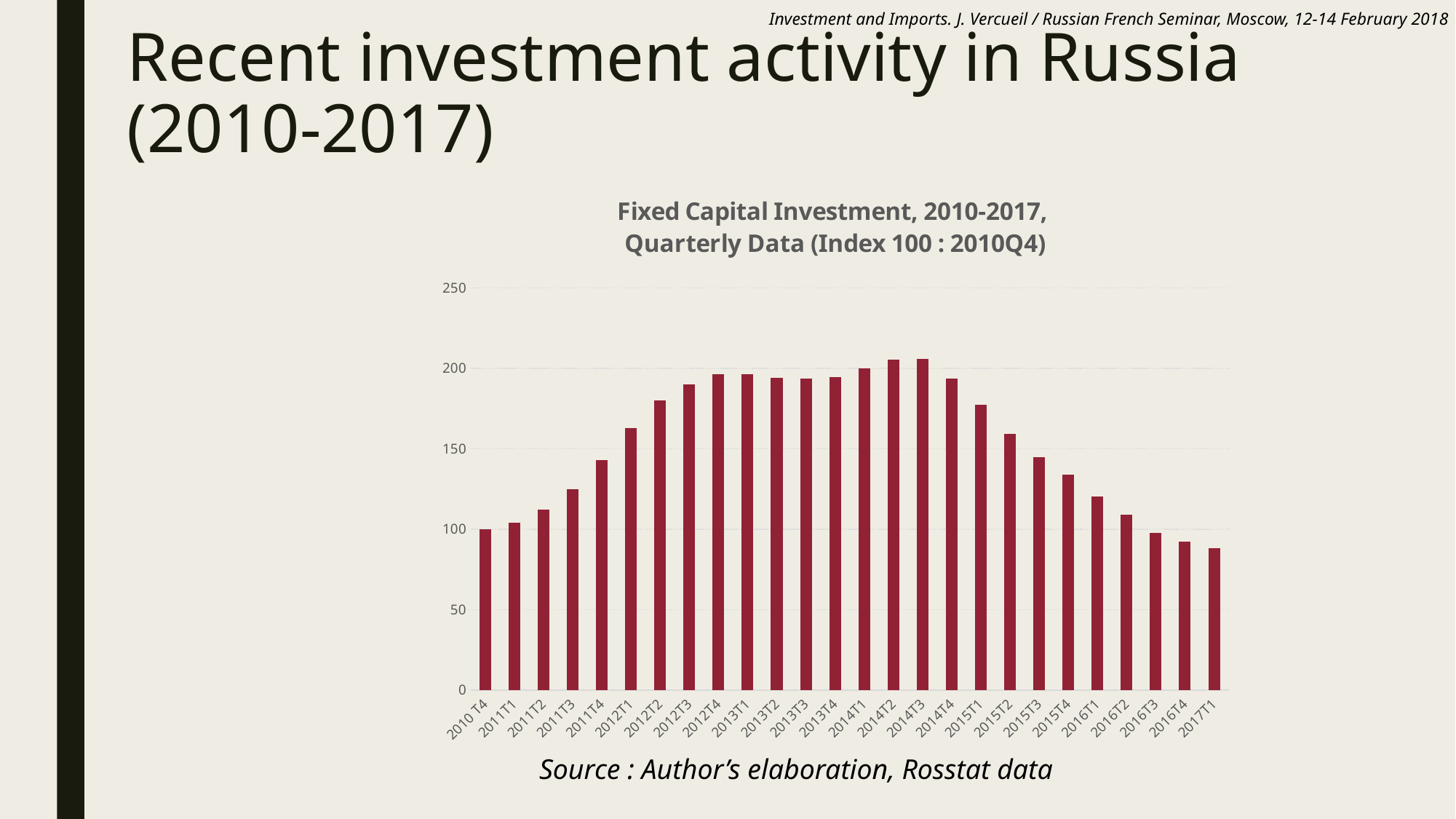
What is the index value for 2010 T4? 100 Is the value for 2014T2 greater or less than 200? greater How many quarterly bars are plotted in the chart? 26 What is the title of the chart? Fixed Capital Investment, 2010-2017, Quarterly Data (Index 100 : 2010Q4) Do the values rise or fall from 2014T3 to 2017T1? fall Is the value for 2015T3 greater or less than 150? less Is the value for 2012T1 greater or less than 150? greater Which quarter has the lowest value in the chart? 2017T1 What kind of chart is shown on the slide? bar chart Which is larger, the value for 2012T2 or the value for 2015T2? 2012T2 Do the values rise or fall from 2010 T4 to 2012T4? rise